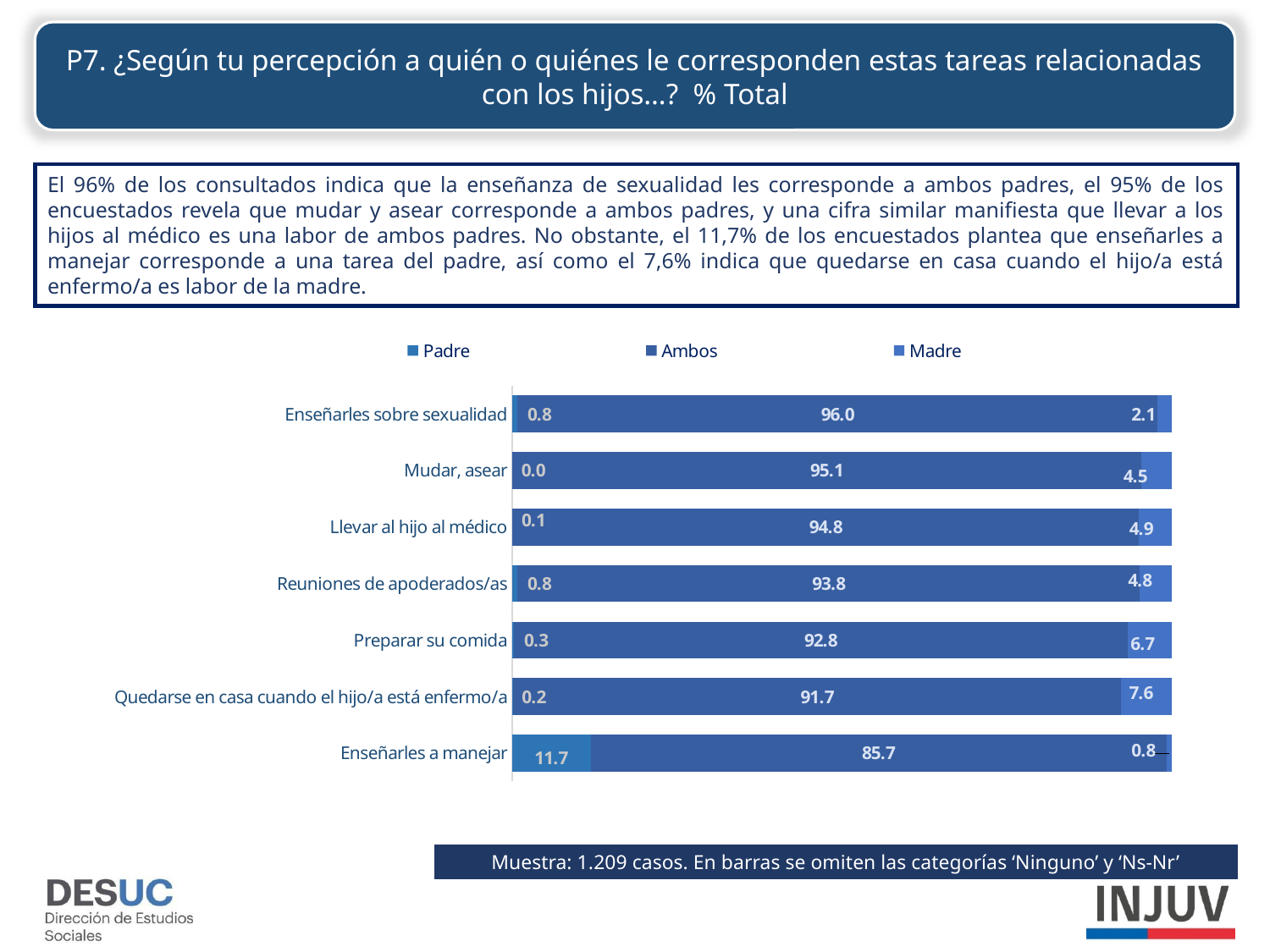
What is the value for Padre for 'Enseñarles a manejar'? 11.7 How many series does the legend list? 3 What is the value for Madre for 'Quedarse en casa cuando el hijo/a está enfermo/a'? 7.6 Which is larger: the Madre value for 'Preparar su comida' or the Madre value for 'Mudar, asear'? Preparar su comida Which category has the highest value for Ambos? Enseñarles sobre sexualidad What is the difference between the Ambos values for 'Enseñarles sobre sexualidad' and 'Enseñarles a manejar'? 10.3 What is the value for Ambos for 'Enseñarles sobre sexualidad'? 96.0 What is the value for Madre for 'Mudar, asear'? 4.5 Which category has the highest value for Padre? Enseñarles a manejar How many categories (tasks) are shown in the chart? 7 Which category has the lowest value for Ambos? Enseñarles a manejar What is the total of the stacked bar for 'Enseñarles a manejar'? 98.2